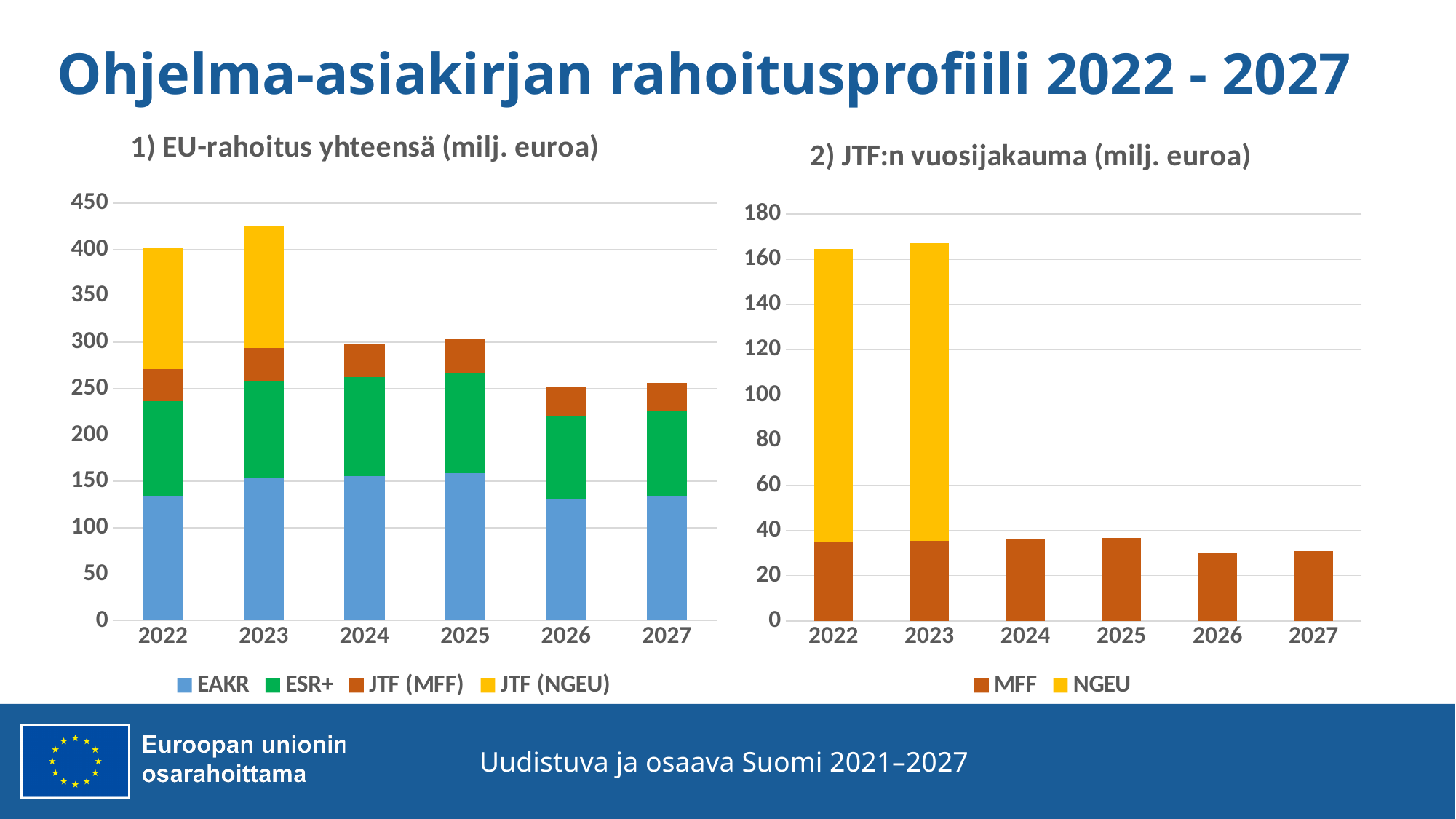
In "2) JTF:n vuosijakauma (milj. euroa)", is the total for 2022 greater or less than 160? greater In "2) JTF:n vuosijakauma (milj. euroa)", which year has the larger total bar, 2023 or 2024? 2023 How many series does the legend of "2) JTF:n vuosijakauma (milj. euroa)" list? 2 How many years are shown on the x axis of "1) EU-rahoitus yhteensä (milj. euroa)"? 6 Which series is shown in yellow in "1) EU-rahoitus yhteensä (milj. euroa)"? JTF (NGEU) In "1) EU-rahoitus yhteensä (milj. euroa)", is the total for 2022 greater or less than 350? greater What kind of chart is "1) EU-rahoitus yhteensä (milj. euroa)"? Stacked bar chart In "1) EU-rahoitus yhteensä (milj. euroa)", which year has the larger total bar, 2023 or 2024? 2023 In "2) JTF:n vuosijakauma (milj. euroa)", is the total for 2024 greater or less than 40? less How many series does the legend of "1) EU-rahoitus yhteensä (milj. euroa)" list? 4 In "1) EU-rahoitus yhteensä (milj. euroa)", which year has the highest total bar? 2023